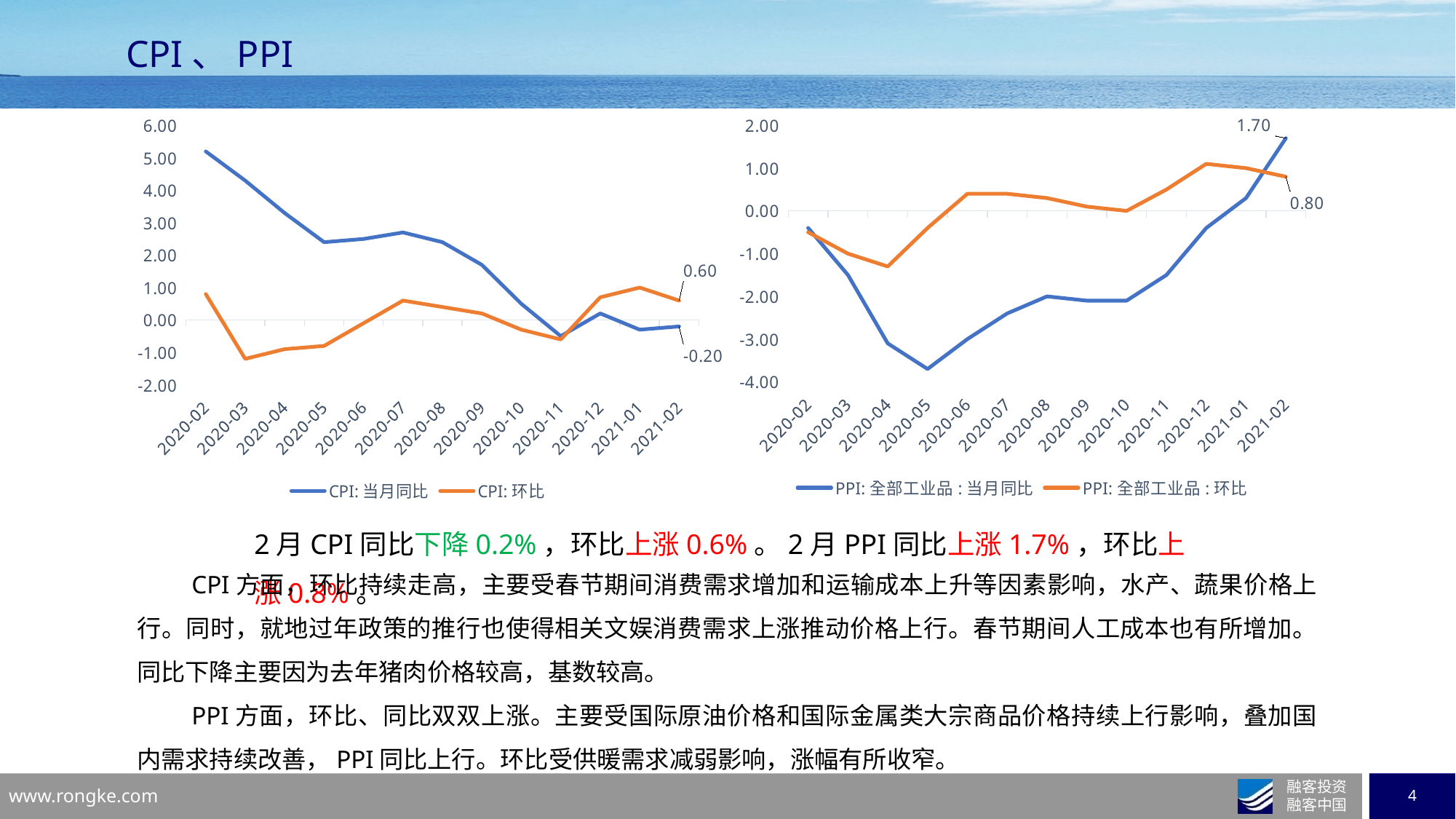
In the right chart (PPI), what is the difference between the 当月同比 and 环比 values for 2021-02? 0.90 In the right chart (PPI), which series has the higher value at 2021-02, 当月同比 or 环比? PPI: 全部工业品: 当月同比 How many series does the legend of the left chart (CPI) list? 2 In the right chart (PPI), what is the value of PPI: 全部工业品: 环比 for 2021-02? 0.80 In the right chart (PPI), in which month is PPI: 全部工业品: 当月同比 lowest? 2020-05 In the left chart (CPI), what is the value of CPI: 环比 for 2021-02? 0.60 In the left chart (CPI), what is the value of CPI: 当月同比 for 2021-02? -0.20 What kind of chart is the left chart (CPI)? line chart In the right chart (PPI), what is the value of PPI: 全部工业品: 当月同比 for 2021-02? 1.70 How many months are shown on the x axis of the right chart (PPI)? 13 In the left chart (CPI), is the value of CPI: 当月同比 for 2020-02 greater or less than 4.00? greater In the left chart (CPI), in which month is CPI: 当月同比 highest? 2020-02